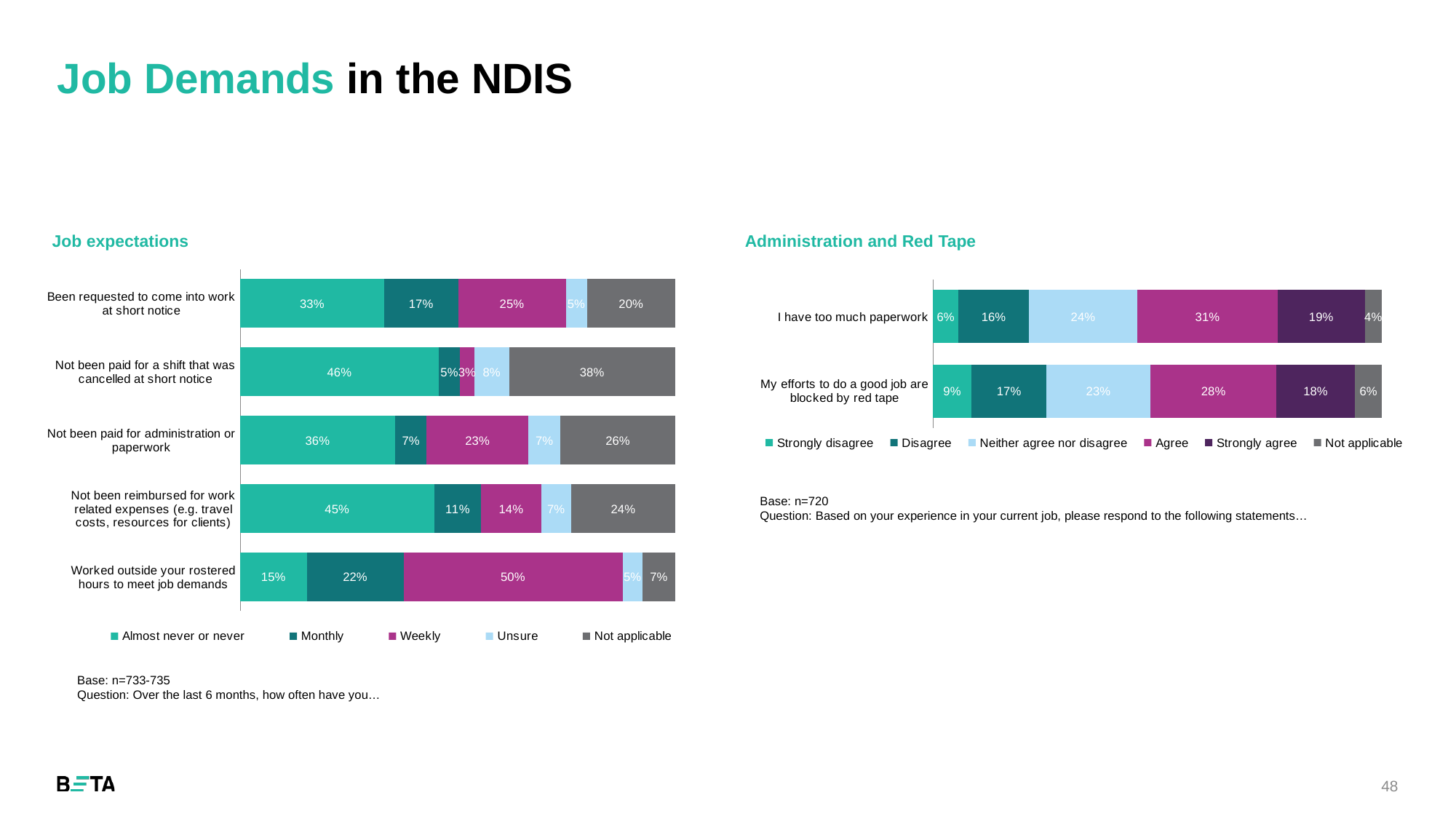
What type of chart is the Administration and Red Tape chart? Stacked bar chart In the Job expectations chart, how many series does the legend list? 5 In the Administration and Red Tape chart, what percentage 'Agree' with 'I have too much paperwork'? 31% In the Job expectations chart, what is the difference between the 'Weekly' values for 'Been requested to come into work at short notice' and 'Not been reimbursed for work related expenses'? 11% In the Administration and Red Tape chart, what is the 'Strongly disagree' value for 'My efforts to do a good job are blocked by red tape'? 9% In the Administration and Red Tape chart, which statement has the larger 'Strongly agree' value? I have too much paperwork In the Job expectations chart, which category has the lowest 'Almost never or never' value? Worked outside your rostered hours to meet job demands In the Job expectations chart, how many categories are shown? 5 In the Job expectations chart, which category has the highest 'Almost never or never' value? Not been paid for a shift that was cancelled at short notice In the Job expectations chart, what percentage of respondents said they 'Weekly' worked outside their rostered hours to meet job demands? 50% In the Job expectations chart, what is the 'Not applicable' value for 'Not been paid for a shift that was cancelled at short notice'? 38% In the Administration and Red Tape chart, how many series does the legend list? 6